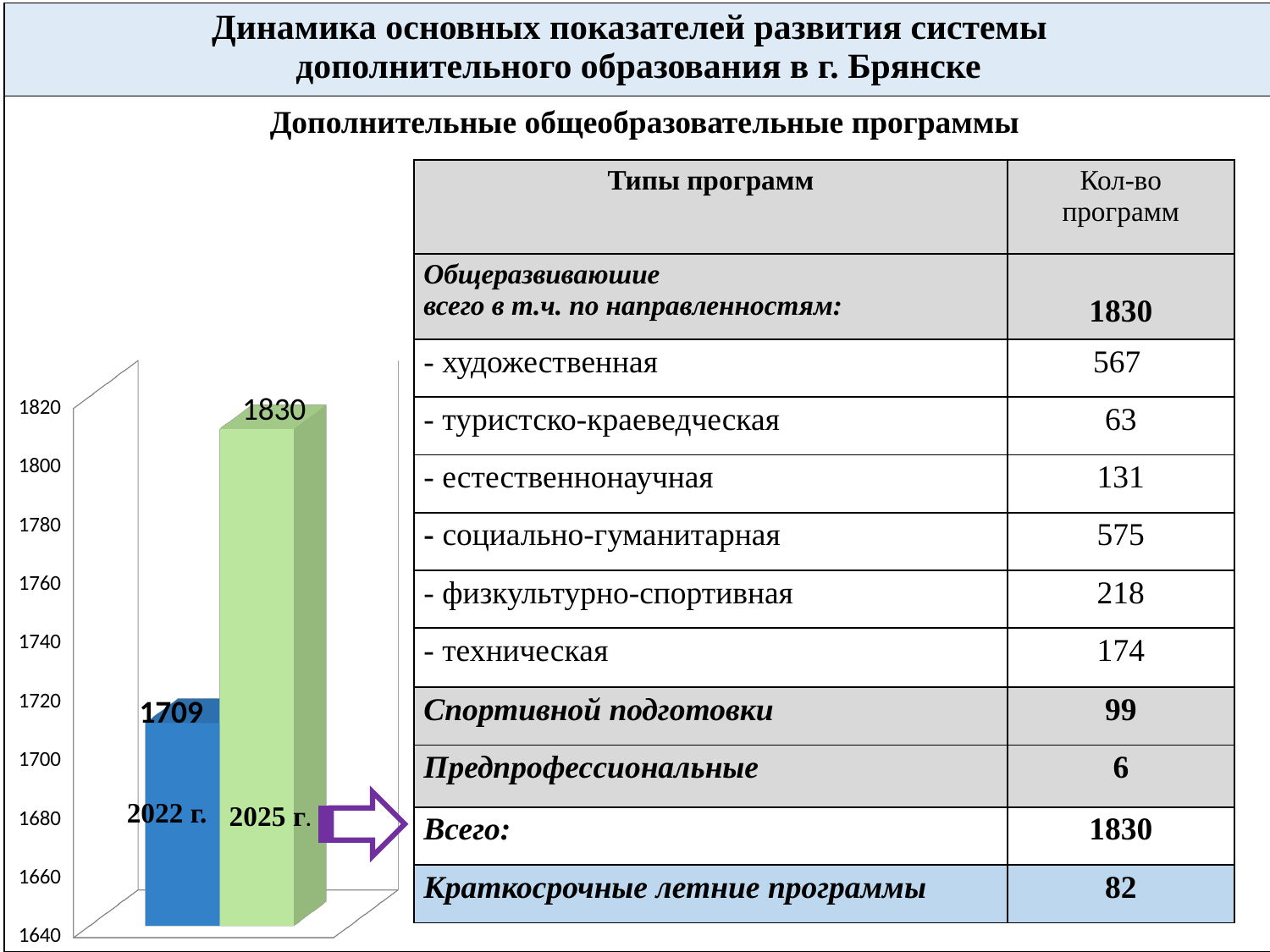
Which year has the higher bar in the chart? 2025 г. Which year has the lower bar in the chart? 2022 г. What value is shown for 2025 г. in the bar chart? 1830 How many bars are plotted in the chart? 2 Do the values rise or fall from 2022 г. to 2025 г.? rise Is the value for 2022 г. larger or smaller than the value for 2025 г.? smaller What is the difference between the 2025 г. and 2022 г. values in the bar chart? 121 What value is shown for 2022 г. in the bar chart? 1709 What kind of chart is shown on the slide? bar chart What colour is the bar for 2025 г.? green Is the value for 2025 г. greater or less than 1800? greater Is the value for 2022 г. greater or less than 1720? less